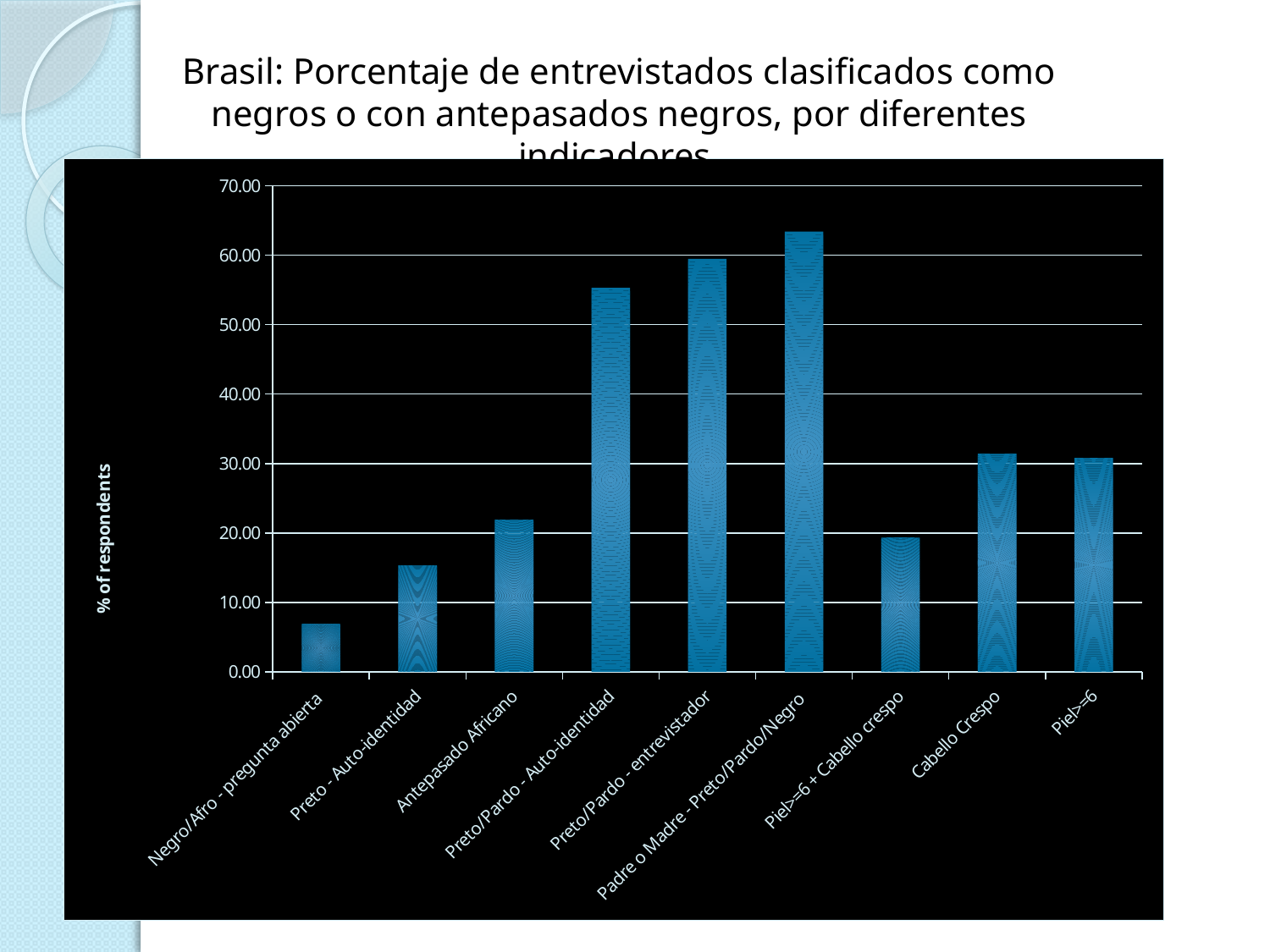
Is the value for Preto - Auto-identidad greater or less than 10.00? greater Which category has the highest value? Padre o Madre - Preto/Pardo/Negro Is the value for Preto/Pardo - Auto-identidad greater or less than 50.00? greater Is the value for Cabello Crespo greater or less than 40.00? less Which category has the lowest value? Negro/Afro - pregunta abierta Which is larger, the value for Piel>=6 + Cabello crespo or the value for Preto/Pardo - entrevistador? Preto/Pardo - entrevistador How many categories (bars) are shown on the chart? 9 Which is larger, the value for Preto/Pardo - Auto-identidad or the value for Antepasado Africano? Preto/Pardo - Auto-identidad What is the title of the vertical axis? % of respondents What kind of chart is shown on the slide? bar chart